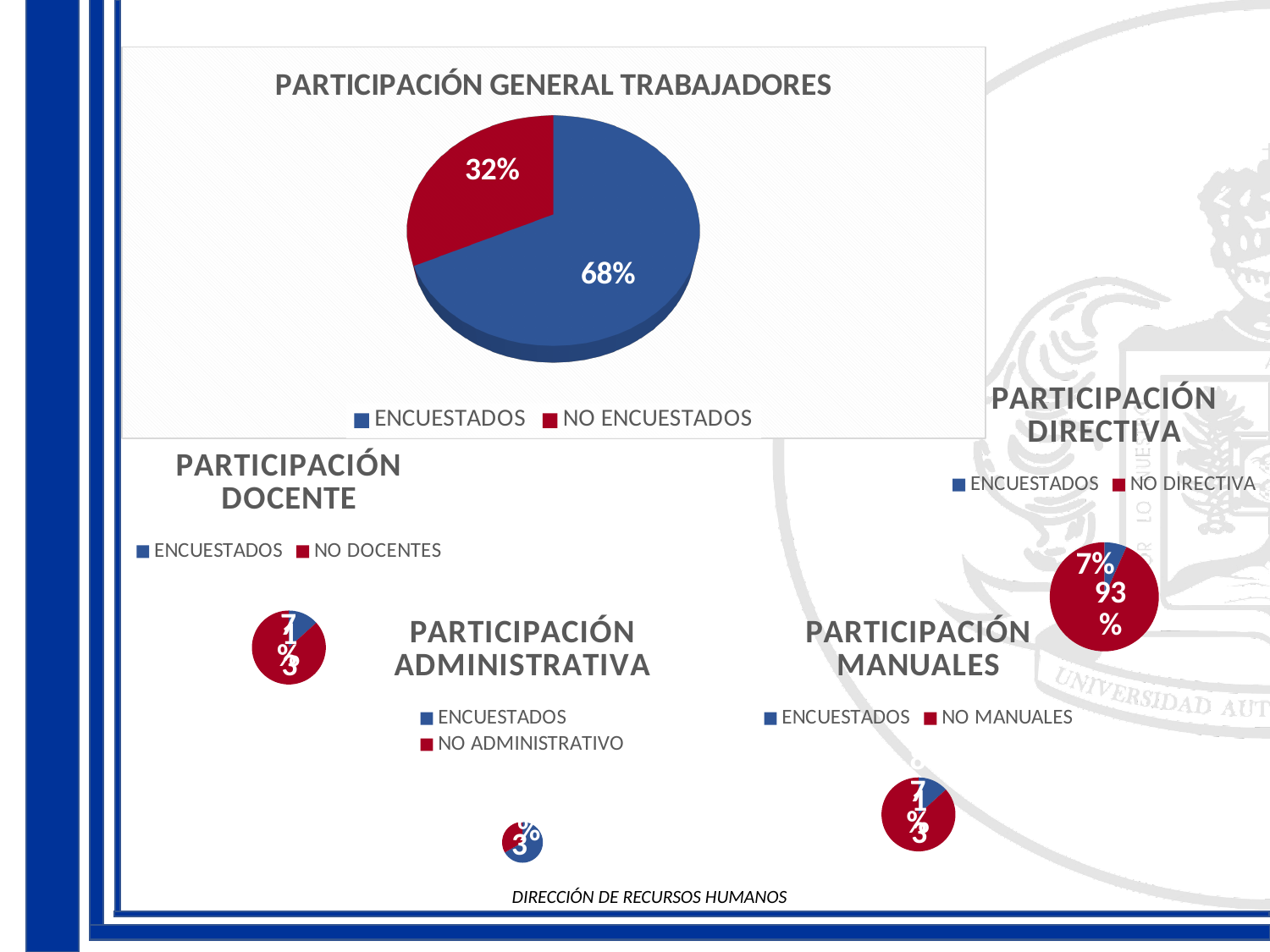
In the PARTICIPACIÓN GENERAL TRABAJADORES chart, what colour is the ENCUESTADOS slice? Blue In the PARTICIPACIÓN DIRECTIVA chart, which category has the largest slice? NO DIRECTIVA In the PARTICIPACIÓN DIRECTIVA chart, what percentage is shown for NO DIRECTIVA? 93% What type of chart is PARTICIPACIÓN GENERAL TRABAJADORES? Pie chart In the PARTICIPACIÓN GENERAL TRABAJADORES chart, what percentage is shown for ENCUESTADOS? 68% In the PARTICIPACIÓN GENERAL TRABAJADORES chart, what is the difference in percentage points between ENCUESTADOS and NO ENCUESTADOS? 36 In the PARTICIPACIÓN GENERAL TRABAJADORES chart, which category has the largest slice? ENCUESTADOS In the PARTICIPACIÓN DIRECTIVA chart, what percentage is shown for ENCUESTADOS? 7% In the PARTICIPACIÓN GENERAL TRABAJADORES chart, what percentage is shown for NO ENCUESTADOS? 32% In the PARTICIPACIÓN GENERAL TRABAJADORES chart, which category has the smallest slice? NO ENCUESTADOS In the PARTICIPACIÓN GENERAL TRABAJADORES chart, which is larger, ENCUESTADOS or NO ENCUESTADOS? ENCUESTADOS How many categories does the legend of the PARTICIPACIÓN GENERAL TRABAJADORES chart list? 2